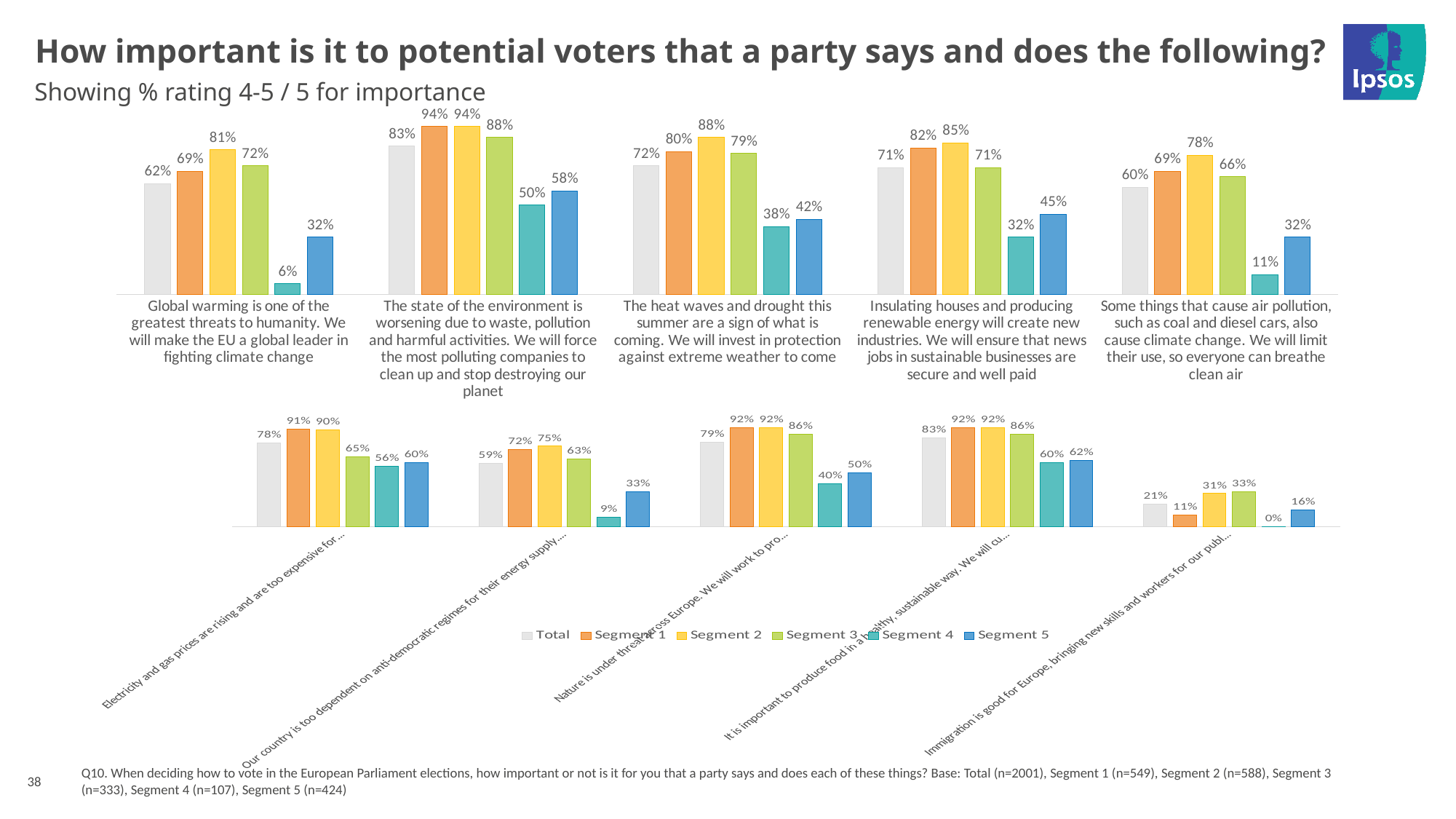
In the top chart, what is the Total value for the statement 'The heat waves and drought this summer are a sign of what is coming'? 72% What kind of chart is the top chart? Bar chart In the bottom chart, what is the Segment 2 value for the statement beginning 'Our country is too dependent on anti-democratic regimes for their energy supply'? 75% In the top chart, which segment has the lowest value for the statement 'Some things that cause air pollution, such as coal and diesel cars, also cause climate change'? Segment 4 In the top chart, what is the Segment 4 value for the statement 'Global warming is one of the greatest threats to humanity'? 6% How many series does the legend list? 6 In the bottom chart, what is the Segment 4 value for the statement beginning 'Immigration is good for Europe'? 0% In the top chart, what is the difference between the Segment 1 and Segment 5 values for the statement 'The state of the environment is worsening due to waste, pollution and harmful activities'? 36% In the top chart, which segment has the highest value for the statement 'Insulating houses and producing renewable energy will create new industries'? Segment 2 How many statements (categories) are shown in the bottom chart? 5 In the top chart, for the statement 'The heat waves and drought this summer are a sign of what is coming', which is larger: the Segment 3 value or the Segment 5 value? Segment 3 In the bottom chart, what is the difference between the Total value for the statement beginning 'Electricity and gas prices are rising' and the Total value for the statement beginning 'Immigration is good for Europe'? 57%